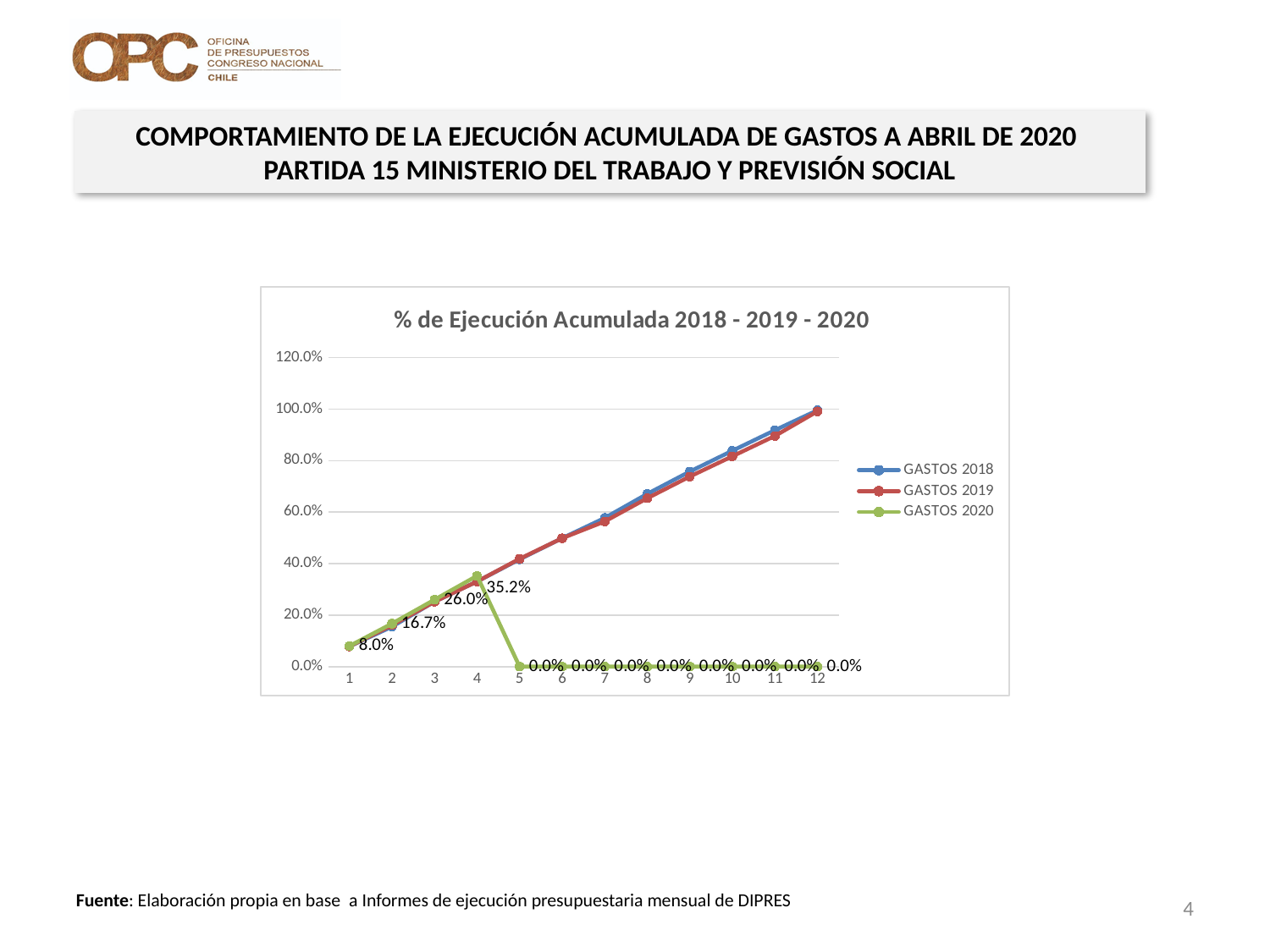
What is the title of the chart? % de Ejecución Acumulada 2018 - 2019 - 2020 What is the value for GASTOS 2020 at point 8? 0.0% What is the value for GASTOS 2020 at point 1? 8.0% What kind of chart is shown on the slide? Line chart Is the value for GASTOS 2018 at point 12 greater or less than 80.0%? greater What is the value for GASTOS 2020 at point 3? 26.0% How many series does the legend list? 3 How many points are shown on the x axis? 12 Is the value for GASTOS 2019 at point 5 greater or less than 60.0%? less What is the value for GASTOS 2020 at point 4? 35.2% Among points 1 to 4, at which point is GASTOS 2020 highest? 4 What is the difference between the GASTOS 2020 values at point 4 and point 1? 27.2%